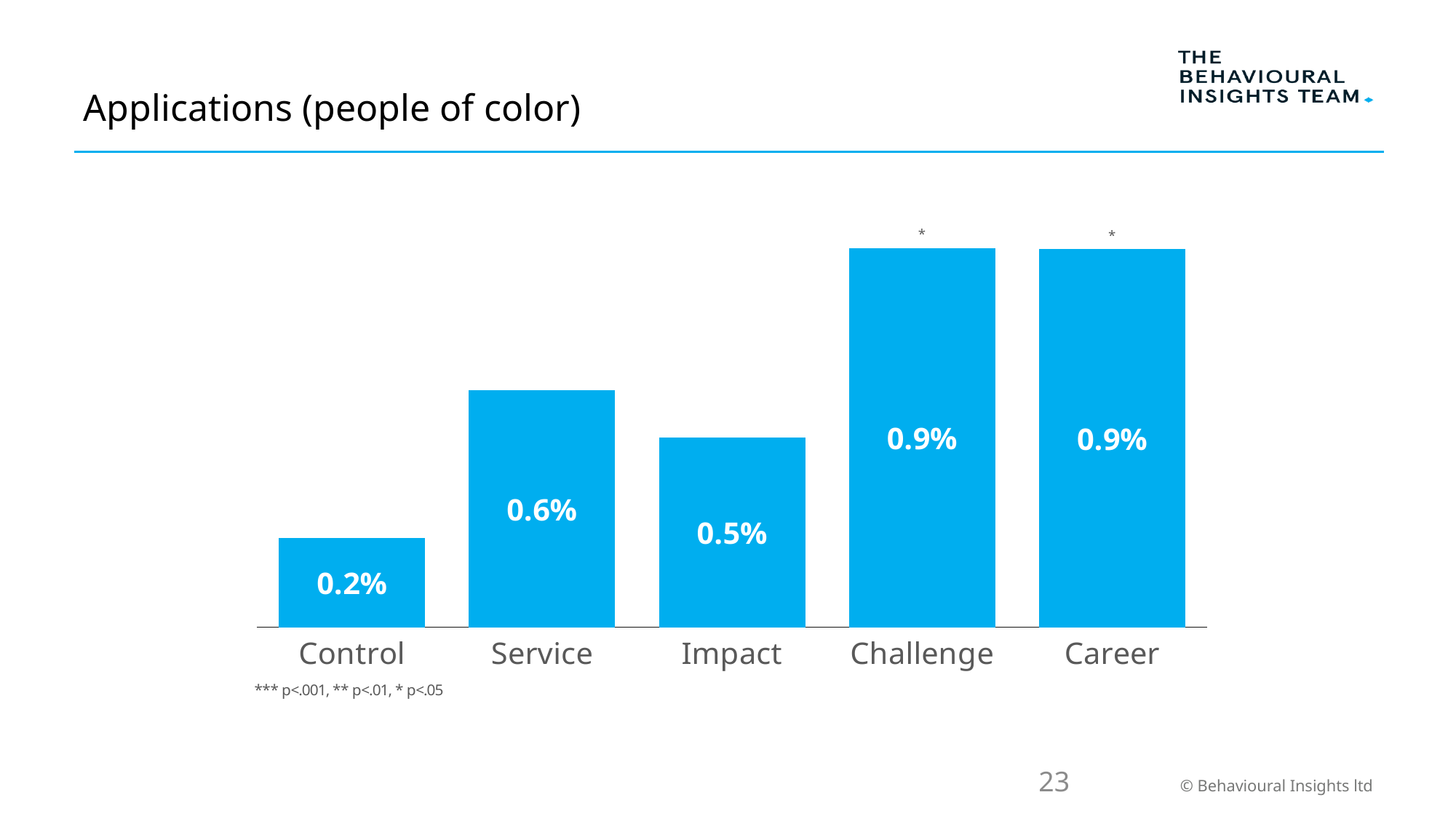
Which category has the lowest value? Control What is the value for Impact? 0.5% What is the value for Service? 0.6% What kind of chart is shown on the slide? Bar chart What is the value for Challenge? 0.9% What is the value for Control? 0.2% How many categories are shown on the x axis? 5 Which is larger, the value for Career or the value for Control? Career What is the title of the slide containing the chart? Applications (people of color) What is the difference between the values for Service and Impact? 0.1% What is the difference between the values for Challenge and Control? 0.7% Which is larger, the value for Service or the value for Impact? Service